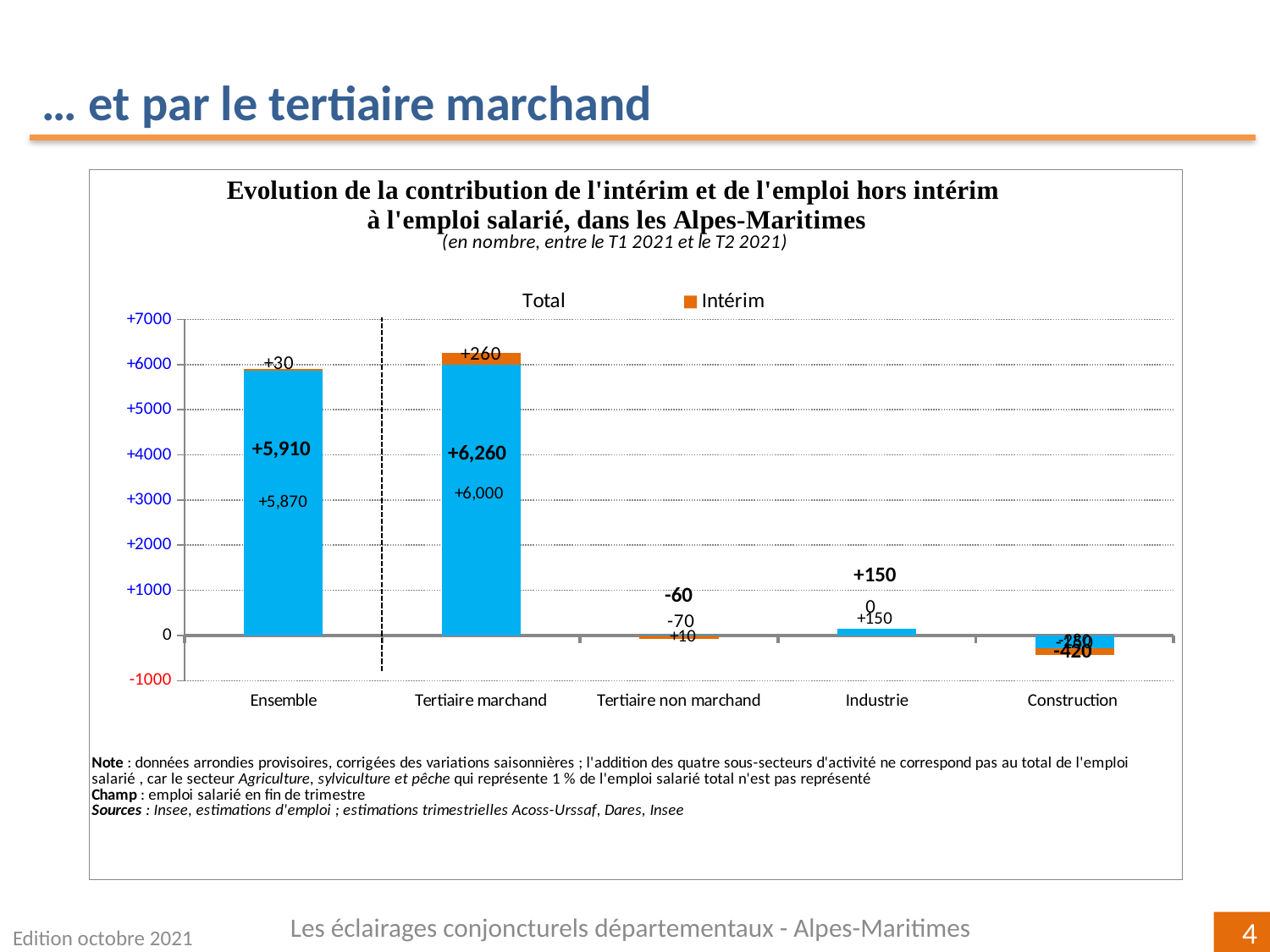
How many categories are shown on the x axis of the chart? 5 What is the difference between the Total value for Tertiaire marchand and the Total value for Ensemble? 350 What is the Total value labelled for Tertiaire non marchand? -60 Which category has the lowest Total value? Construction What is the Intérim value labelled for Ensemble? +30 What kind of chart is shown on the slide? Bar chart What is the Intérim value labelled for Tertiaire marchand? +260 What is the Total value labelled for Construction? -420 What is the Total value labelled for Industrie? +150 What is the Total value labelled for Ensemble? +5,910 Which category has the highest Total value? Tertiaire marchand What is the Total value labelled for Tertiaire marchand? +6,260